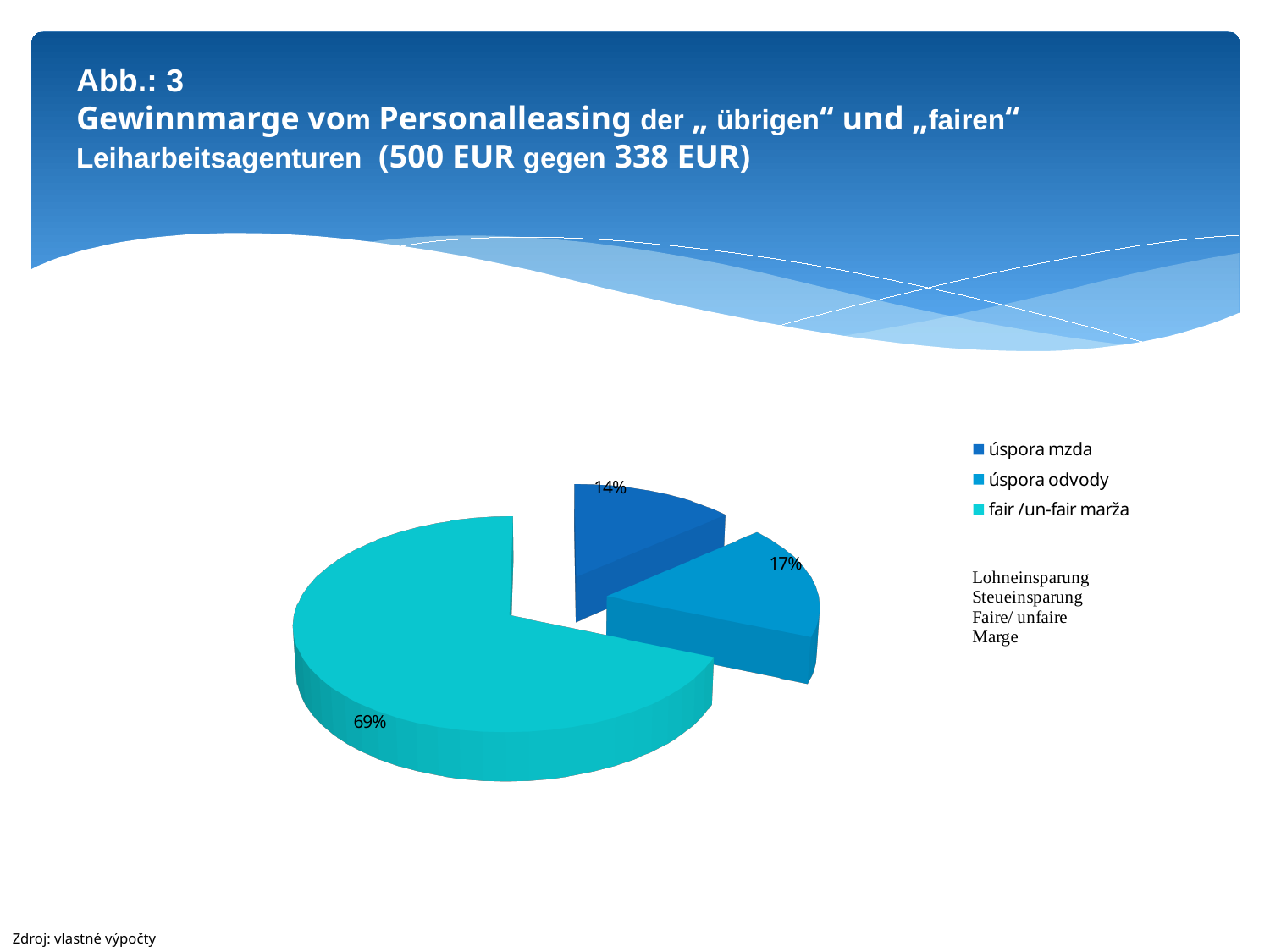
Which slice of the pie is the smallest? úspora mzda How many slices does the pie chart have? 3 What type of chart is shown on the slide? pie chart What share of the pie does "fair /un-fair marža" represent? 69% Which slice of the pie is the largest? fair /un-fair marža What is the difference in percentage points between "úspora odvody" and "úspora mzda"? 3 What share of the pie does "úspora odvody" represent? 17% What share of the pie does "úspora mzda" represent? 14% What colour is the slice for "fair /un-fair marža"? cyan How many entries does the legend list? 3 Which is larger, the share for "úspora odvody" or the share for "úspora mzda"? úspora odvody What is the difference in percentage points between "fair /un-fair marža" and "úspora odvody"? 52